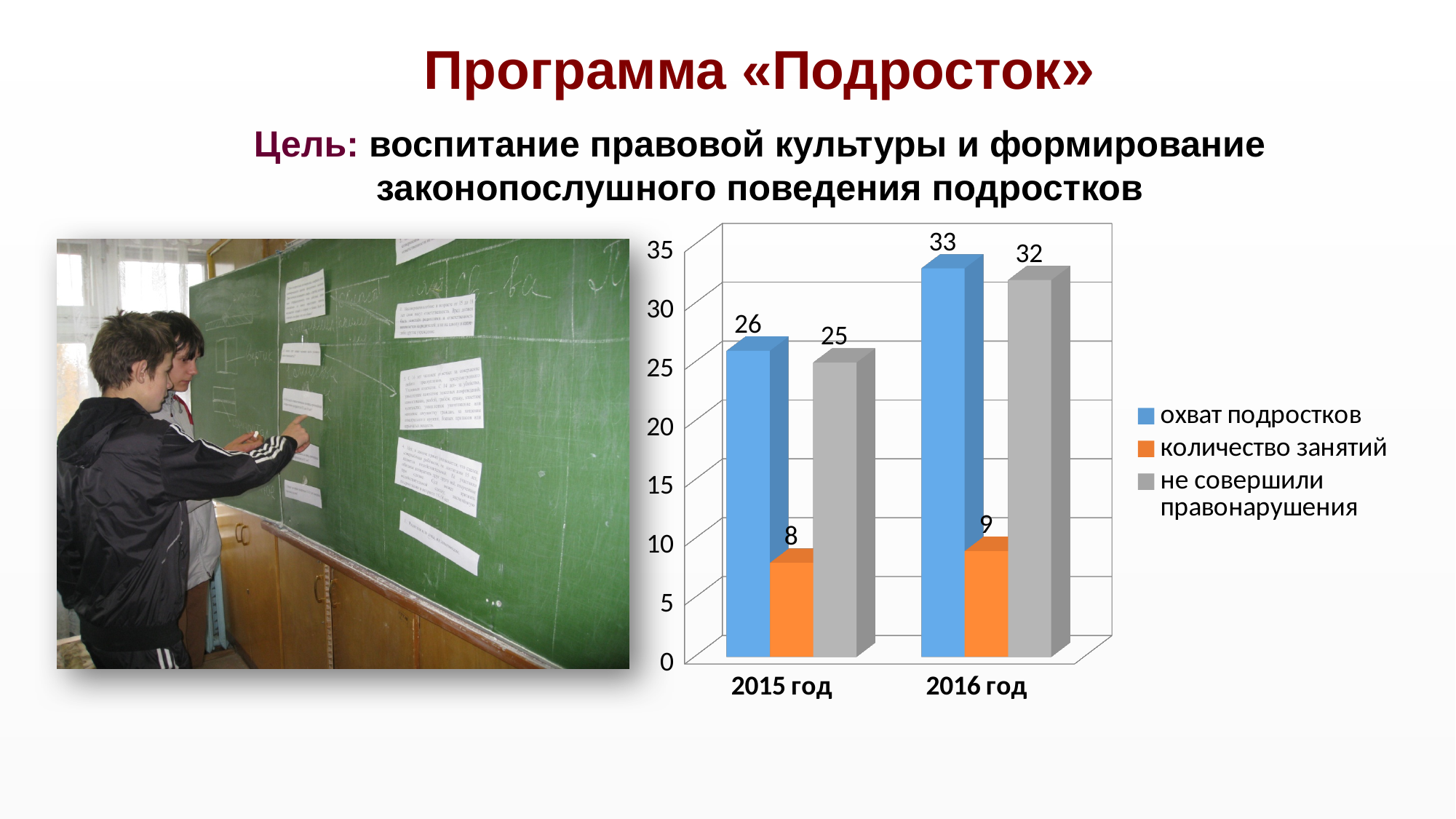
Which is larger: "не совершили правонарушения" in 2016 год or "охват подростков" in 2015 год? не совершили правонарушения in 2016 год Which series has the highest value in 2015 год? охват подростков What is the value for "не совершили правонарушения" in 2016 год? 32 How many categories are shown on the x axis? 2 What is the value for "охват подростков" in 2015 год? 26 How many series does the legend list? 3 What is the value for "количество занятий" in 2016 год? 9 Does the value for "количество занятий" rise or fall from 2015 год to 2016 год? rise What kind of chart is shown on the slide? bar chart Which series has the lowest value in 2016 год? количество занятий What is the difference between "охват подростков" in 2016 год and in 2015 год? 7 What is the value for "не совершили правонарушения" in 2015 год? 25